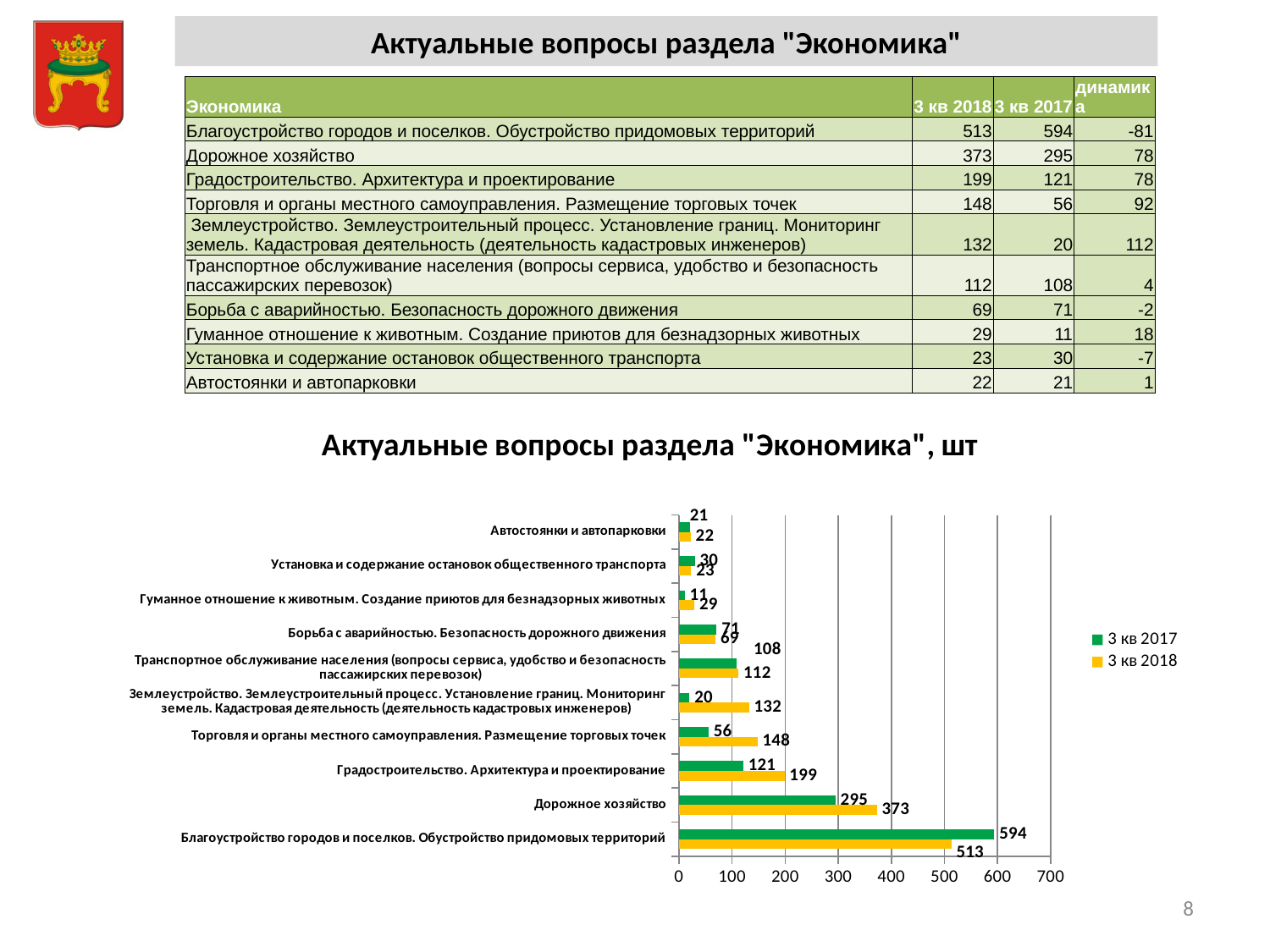
How many series does the chart legend list? 2 Which colour represents the "3 кв 2018" series in the chart? yellow Is the "3 кв 2018" value for "Дорожное хозяйство" greater or less than 300? greater What is the title of the chart? Актуальные вопросы раздела "Экономика", шт What kind of chart is shown on the slide? bar chart What is the difference between the "3 кв 2017" and "3 кв 2018" values for "Благоустройство городов и поселков. Обустройство придомовых территорий"? 81 Which category has the highest value in the "3 кв 2018" series? Благоустройство городов и поселков. Обустройство придомовых территорий Which category has the lowest value in the "3 кв 2017" series? Гуманное отношение к животным. Создание приютов для безнадзорных животных How many categories are plotted in the chart? 10 What is the value for "Градостроительство. Архитектура и проектирование" in the "3 кв 2017" series? 121 What is the value for "Дорожное хозяйство" in the "3 кв 2018" series? 373 For "Торговля и органы местного самоуправления. Размещение торговых точек", which series has the larger value, "3 кв 2017" or "3 кв 2018"? 3 кв 2018